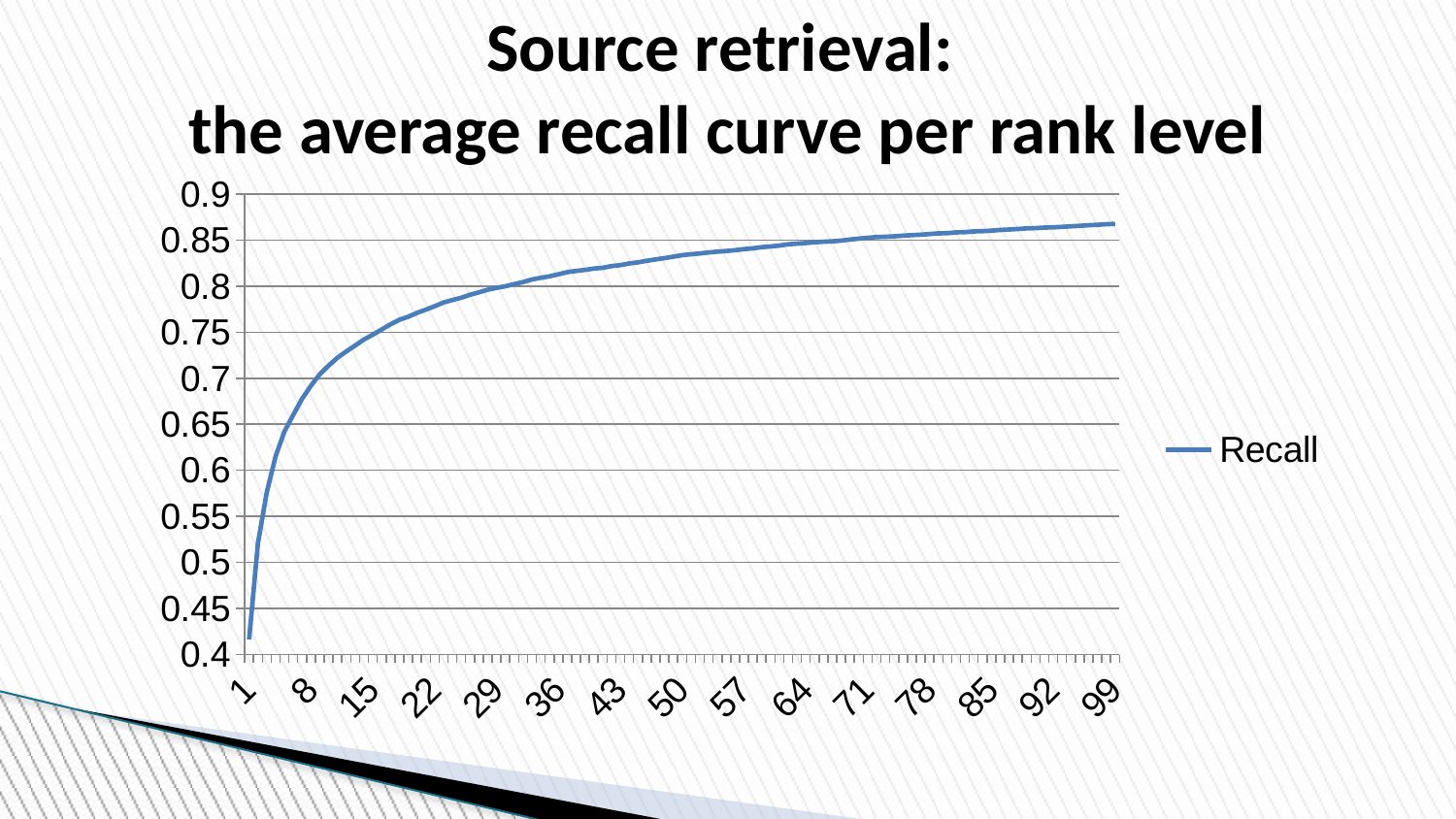
How many series does the legend list? 1 Is the recall value at rank 99 greater or less than 0.85? greater What is the title of the chart? Source retrieval: the average recall curve per rank level What is the name of the series shown in the legend? Recall Is the recall value at rank 1 greater or less than 0.5? less Do the recall values rise or fall as the rank level increases along the x axis? rise Is the recall value at rank 15 greater or less than 0.7? greater At which rank level shown on the x axis is the recall value lowest? 1 At which rank level shown on the x axis is the recall value highest? 99 What kind of chart is shown on the slide? line chart Which has the larger recall value, rank 8 or rank 43? rank 43